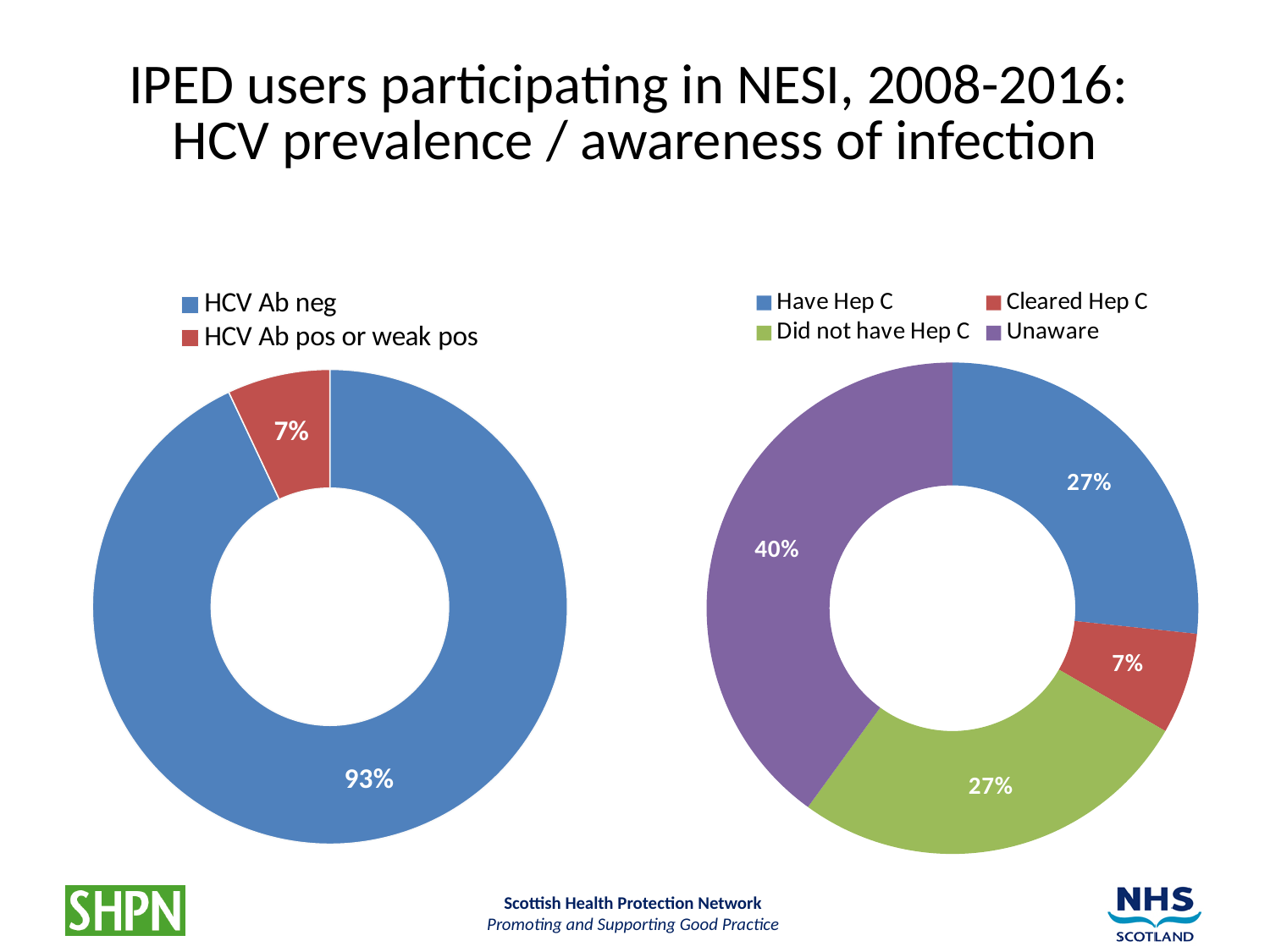
In the right chart, which category has the smallest share? Cleared Hep C In the right chart, what is the difference in percentage points between Unaware and Did not have Hep C? 13 In the right chart, which category has the largest share? Unaware What type of chart is the left chart? Doughnut chart In the right chart, which is larger: Unaware or Have Hep C? Unaware In the left chart, what percentage is shown for HCV Ab pos or weak pos? 7% In the right chart, what percentage is shown for Have Hep C? 27% In the left chart, what is the difference in percentage points between HCV Ab neg and HCV Ab pos or weak pos? 86 In the left chart, what percentage is shown for HCV Ab neg? 93% In the right chart, what percentage is shown for Cleared Hep C? 7% In the right chart, what percentage is shown for Unaware? 40% How many categories does the legend of the right chart list? 4